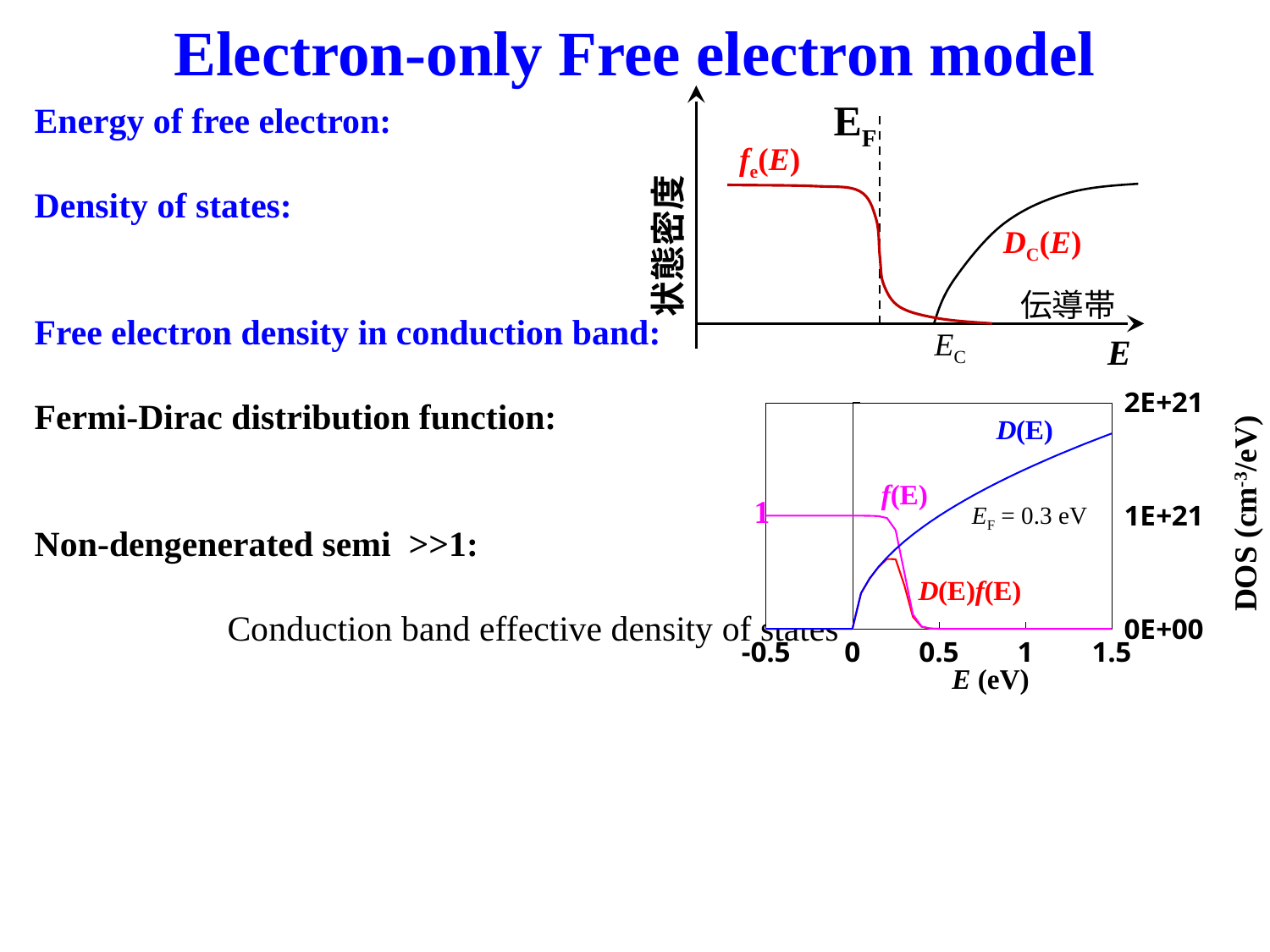
In the bottom chart, is the value of D(E) at E = 1 eV greater or less than 1E+21? greater In the bottom chart, which curve is larger at E = 1 eV, D(E) or D(E)f(E)? D(E) In the bottom chart, what is the lowest tick value shown on the E (eV) axis? -0.5 In the bottom chart, what is the maximum tick value shown on the DOS axis? 2E+21 In the bottom chart, does the D(E) curve rise or fall as E increases above 0 eV? rise What kind of chart is the bottom chart with the E (eV) axis? line chart In the bottom chart, what value of the Fermi energy E_F is annotated? 0.3 eV In the bottom chart, is the value of D(E) at E = 1.5 eV greater or less than 2E+21? less In the bottom chart, how many curves are plotted? 3 In the bottom chart, which curve has the highest value at E = 1.5 eV? D(E) In the top schematic chart, what label is given to the black curve? D_C(E) In the bottom chart, what is the label of the right-hand vertical axis? DOS (cm-3/eV)